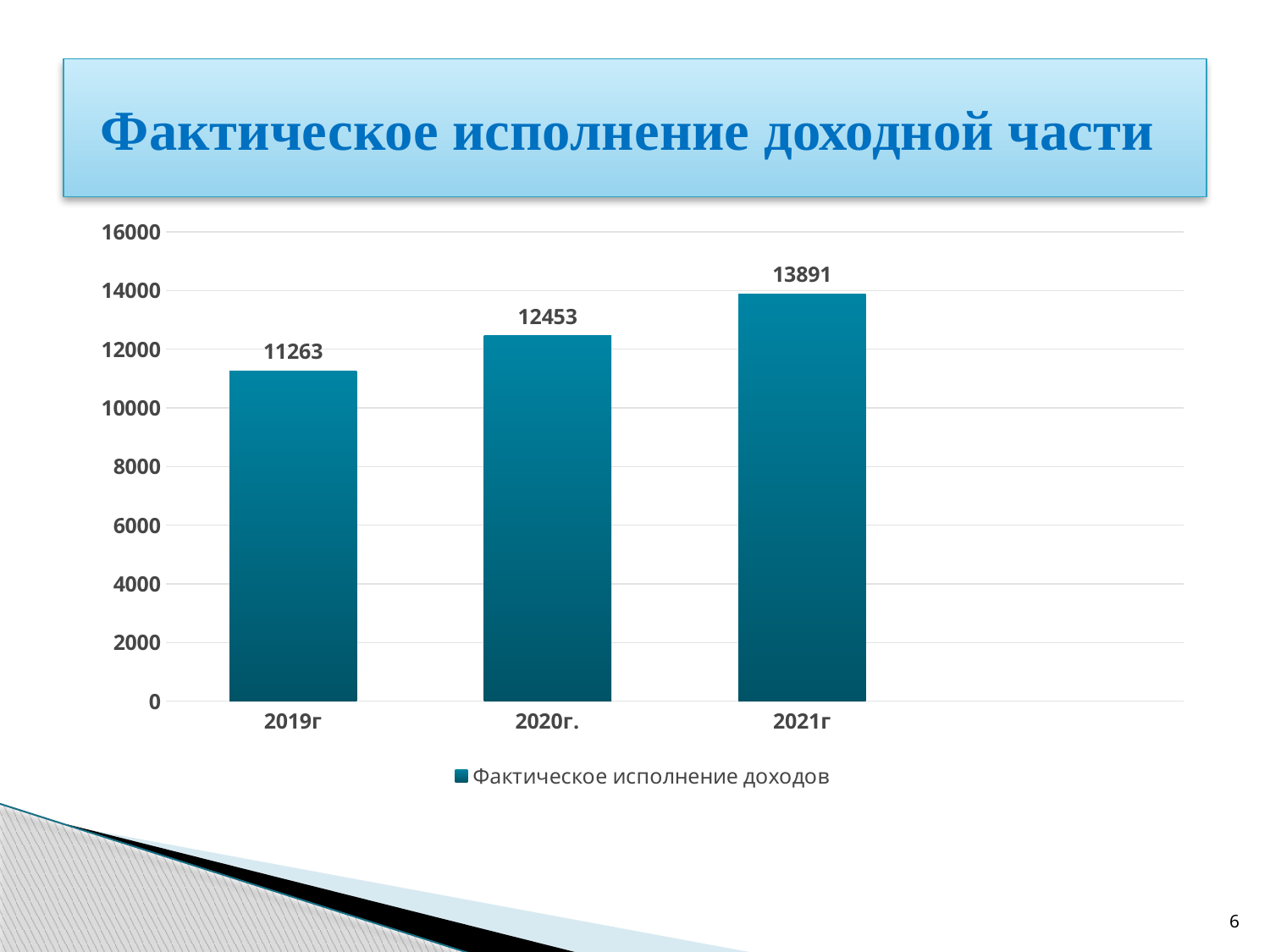
Which year has the lowest value? 2019г Which is larger, the value for 2020г. or the value for 2021г? 2021г Is the value for 2019г greater or less than 12000? less Which year has the highest value? 2021г What kind of chart is shown on the slide? bar chart What is the value for 2019г? 11263 How many bars are shown in the chart? 3 What is the difference between the values for 2021г and 2019г? 2628 What is the value for 2020г.? 12453 Do the values rise or fall from 2019г to 2021г? rise What is the difference between the values for 2020г. and 2019г? 1190 What is the value for 2021г? 13891